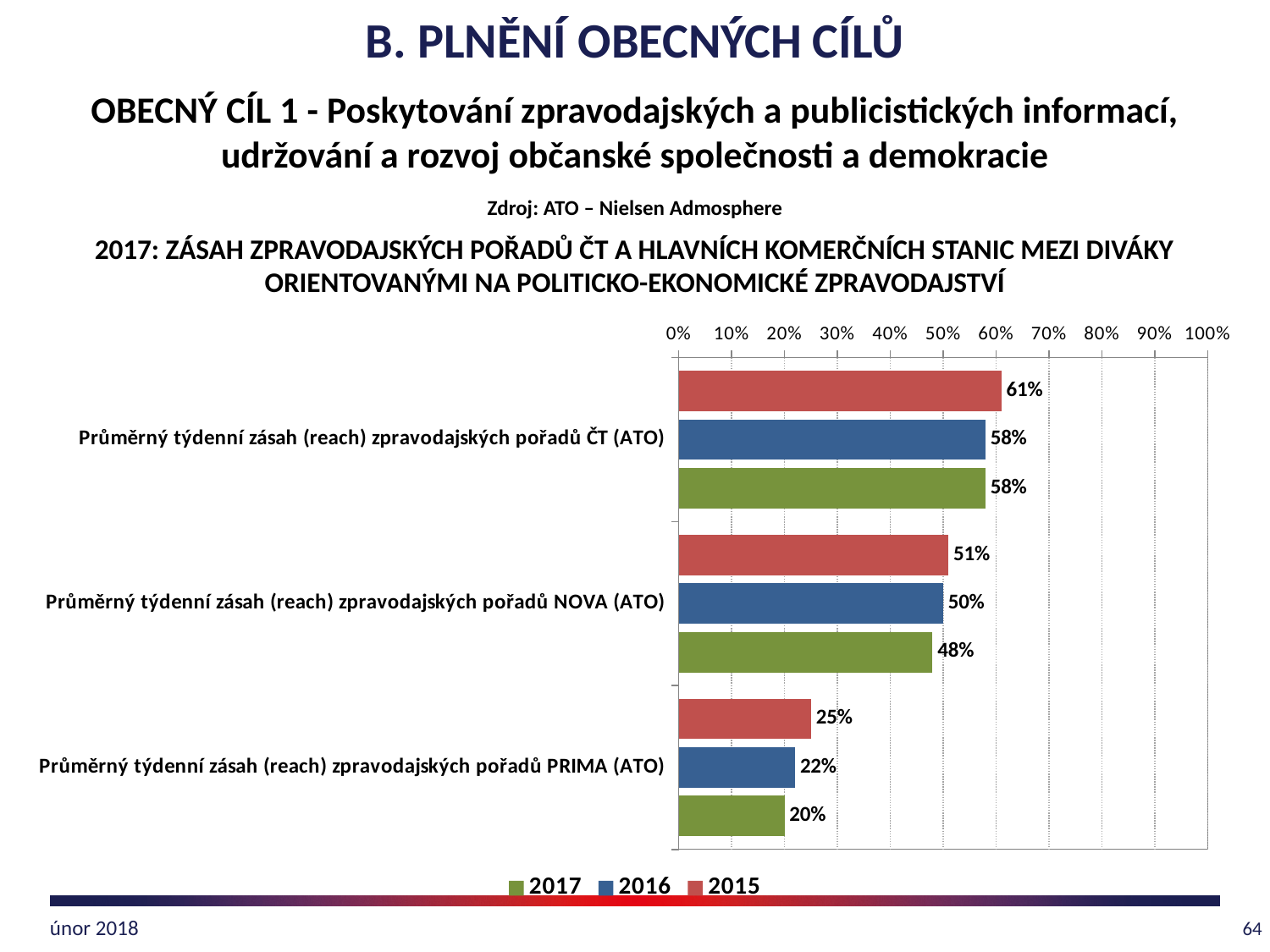
Which colour represents the 2016 series in the legend? Blue What is the 2017 value for Průměrný týdenní zásah (reach) zpravodajských pořadů ČT (ATO)? 58% Which category has the lowest 2017 value? Průměrný týdenní zásah (reach) zpravodajských pořadů PRIMA (ATO) What is the 2016 value for Průměrný týdenní zásah (reach) zpravodajských pořadů PRIMA (ATO)? 22% What kind of chart is shown on the slide? Bar chart Which is larger for Průměrný týdenní zásah (reach) zpravodajských pořadů NOVA (ATO): the 2015 value or the 2017 value? 2015 Did the value for Průměrný týdenní zásah (reach) zpravodajských pořadů NOVA (ATO) rise or fall from 2015 to 2017? Fall What is the 2015 value for Průměrný týdenní zásah (reach) zpravodajských pořadů NOVA (ATO)? 51% What is the difference between the 2015 and 2017 values for Průměrný týdenní zásah (reach) zpravodajských pořadů PRIMA (ATO)? 5% How many series does the legend list? 3 How many categories are shown on the chart? 3 Which category has the highest 2015 value? Průměrný týdenní zásah (reach) zpravodajských pořadů ČT (ATO)